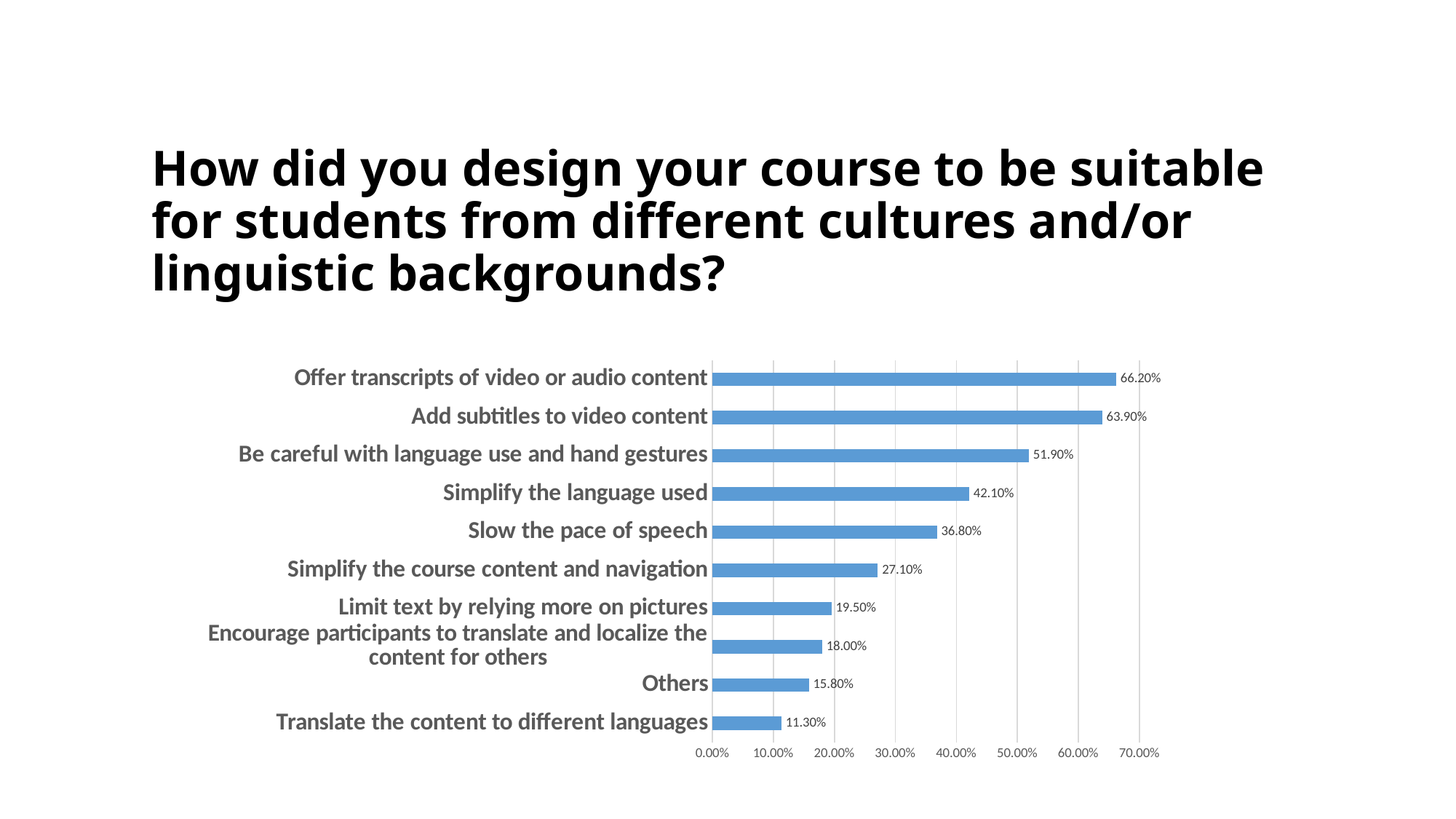
What kind of chart is shown on the slide? Bar chart What is the value for "Translate the content to different languages"? 11.30% Which category has the lowest value? Translate the content to different languages What is the value for "Others"? 15.80% What percentage of respondents said they offer transcripts of video or audio content? 66.20% How many categories are shown in the chart? 10 What is the value for "Slow the pace of speech"? 36.80% Is the value for "Be careful with language use and hand gestures" greater or less than 50.00%? greater Which is larger: "Simplify the course content and navigation" or "Limit text by relying more on pictures"? Simplify the course content and navigation What is the highest value shown on the x axis? 70.00% Which category has the highest value? Offer transcripts of video or audio content What is the difference between "Add subtitles to video content" and "Simplify the language used"? 21.80%